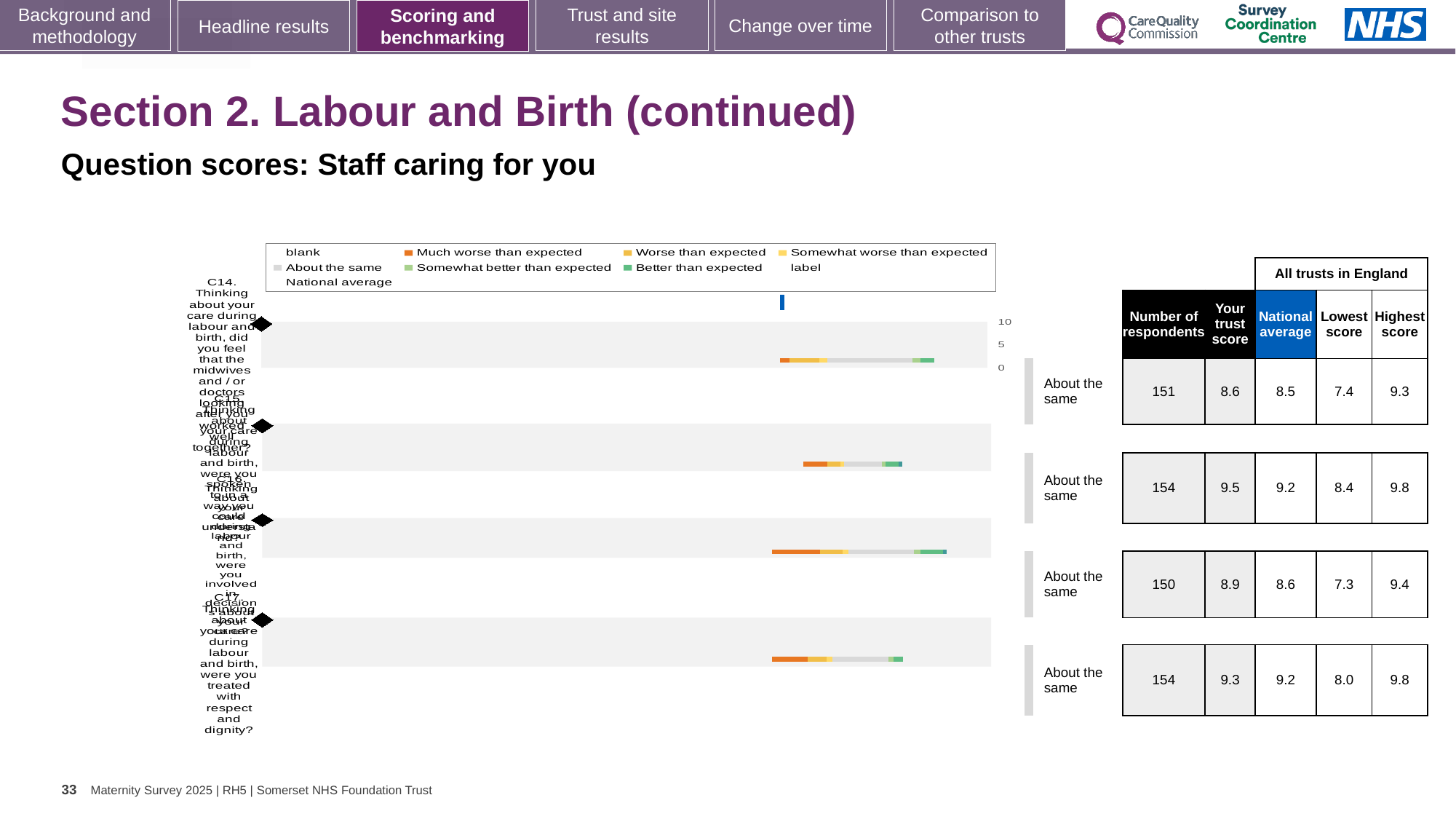
What kind of chart is shown on the slide? bar chart Which row has the highest 'Your trust score' in the table? C15 (9.5) How many questions (rows) are plotted in the chart? 4 What is the difference between the trust score and the national average for the third row (C16)? 0.3 Which row has the lowest 'Lowest score' value in the table? C16 (7.3) What colour does the legend use for 'Much worse than expected'? orange For the first row (C14), which is larger: the trust score or the national average? the trust score (8.6) In the table next to the chart, what is the 'Your trust score' for the first row (C14)? 8.6 In the table next to the chart, what is the national average for the second row (C15)? 9.2 In the table next to the chart, what is the number of respondents for the third row (C16)? 150 What benchmark category is shown for every question on this slide? About the same In the table next to the chart, what is the highest score for the fourth row (C17)? 9.8